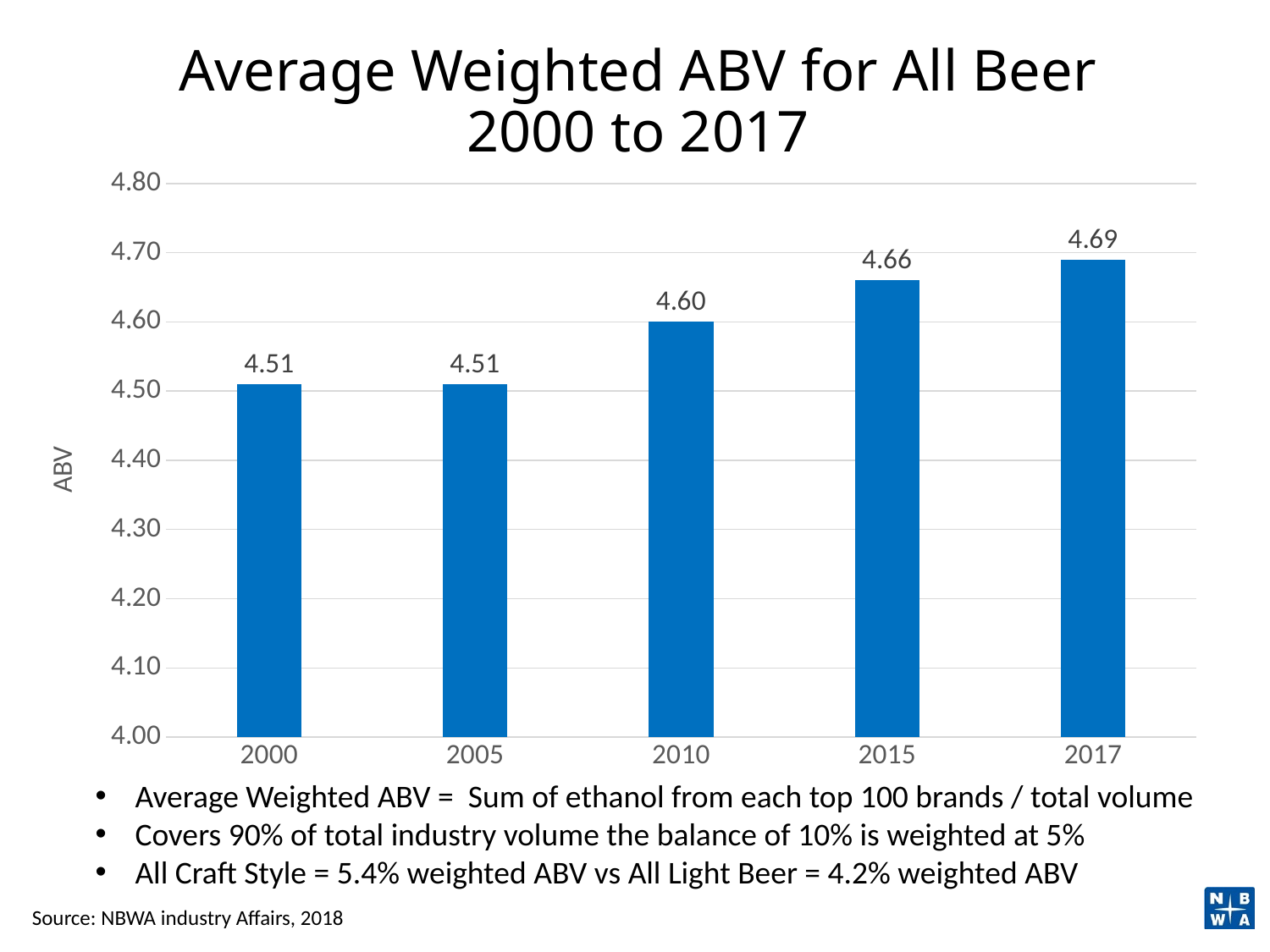
What is the average weighted ABV for 2010? 4.60 Which year has the larger average weighted ABV, 2010 or 2015? 2015 What is the average weighted ABV for 2017? 4.69 What is the difference in average weighted ABV between 2015 and 2010? 0.06 Is the average weighted ABV for 2005 greater or less than 4.60? less How many years are shown on the x axis of the chart? 5 Which year has the highest average weighted ABV? 2017 What is the difference in average weighted ABV between 2017 and 2000? 0.18 What is the title of the chart? Average Weighted ABV for All Beer 2000 to 2017 What kind of chart is shown on the slide? bar chart Do the average weighted ABV values rise or fall from 2000 to 2017? rise What is the average weighted ABV for 2000? 4.51